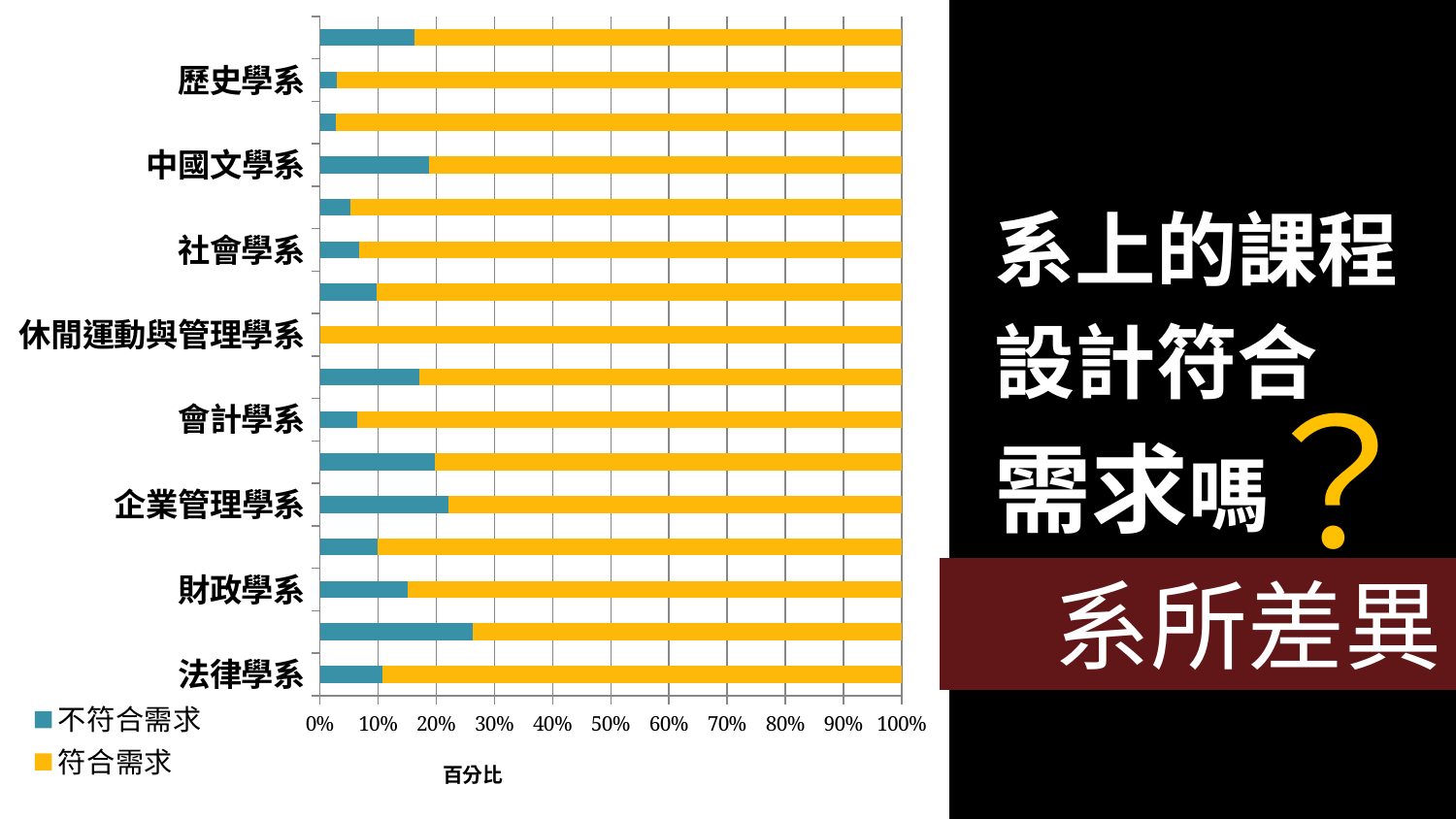
What is the title of the horizontal axis? 百分比 What kind of chart is shown on the slide? bar chart Is the 不符合需求 value for 財政學系 greater or less than 20%? less Is the 不符合需求 value for 企業管理學系 greater or less than 10%? greater Is the 不符合需求 value for 中國文學系 greater or less than 10%? greater Which has a larger 不符合需求 share, 中國文學系 or 歷史學系? 中國文學系 How many bars are plotted in the chart? 16 Which has a larger 不符合需求 share, 企業管理學系 or 法律學系? 企業管理學系 What are the two series named in the legend? 不符合需求 and 符合需求 How many series does the legend list? 2 Which labelled department has the lowest 不符合需求 share? 休閒運動與管理學系